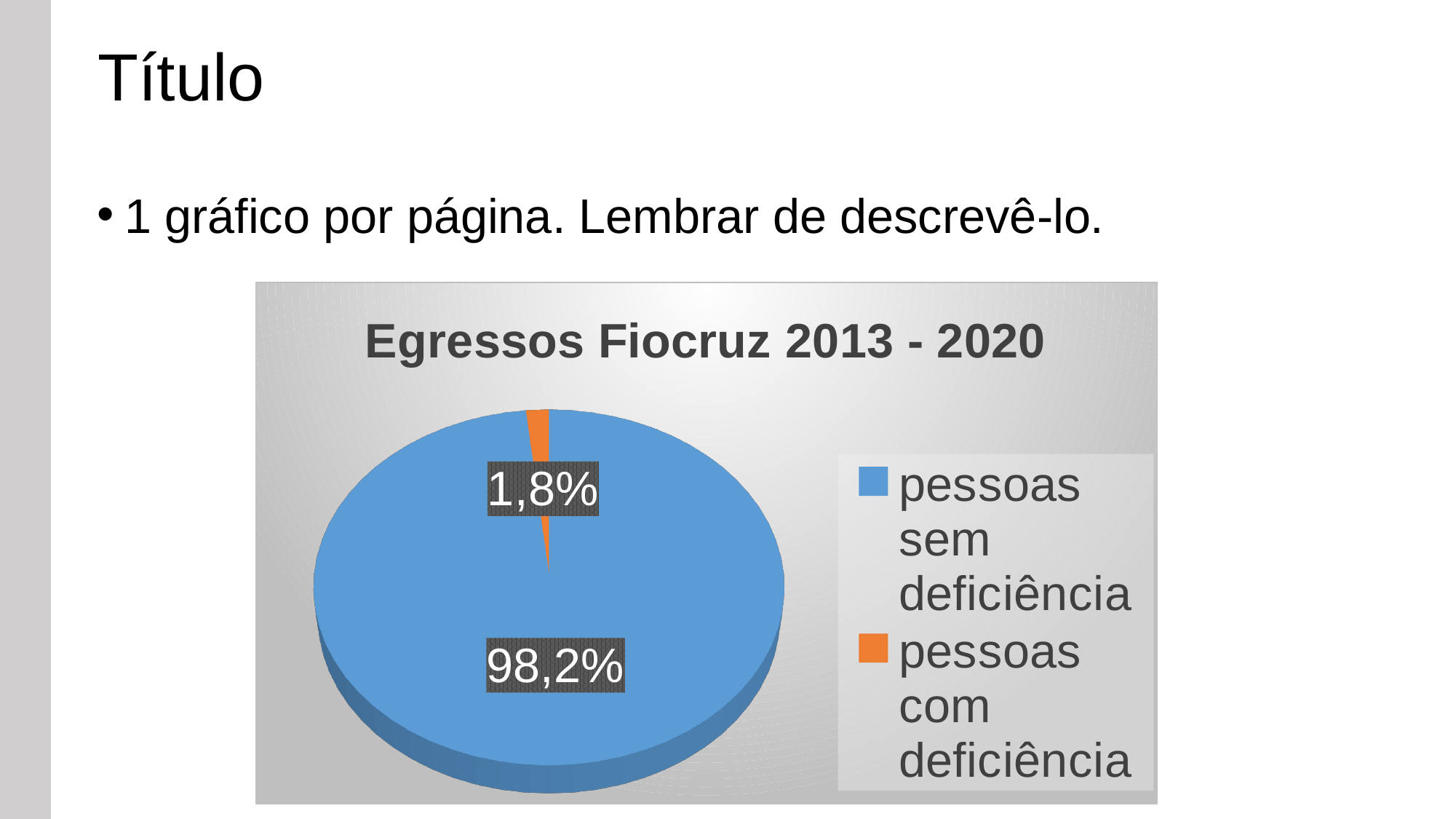
What share of the pie is 'pessoas sem deficiência'? 98,2% How many categories does the pie chart show? 2 What colour is the slice for 'pessoas com deficiência'? orange Which is larger: the slice for 'pessoas sem deficiência' or the slice for 'pessoas com deficiência'? pessoas sem deficiência What share of the pie is 'pessoas com deficiência'? 1,8% How many entries does the legend list? 2 What is the title of the chart? Egressos Fiocruz 2013 - 2020 Which category has the largest slice of the pie? pessoas sem deficiência What is the difference in percentage points between the 'pessoas sem deficiência' slice and the 'pessoas com deficiência' slice? 96,4 What kind of chart is shown on the slide? pie chart Which category has the smallest slice of the pie? pessoas com deficiência